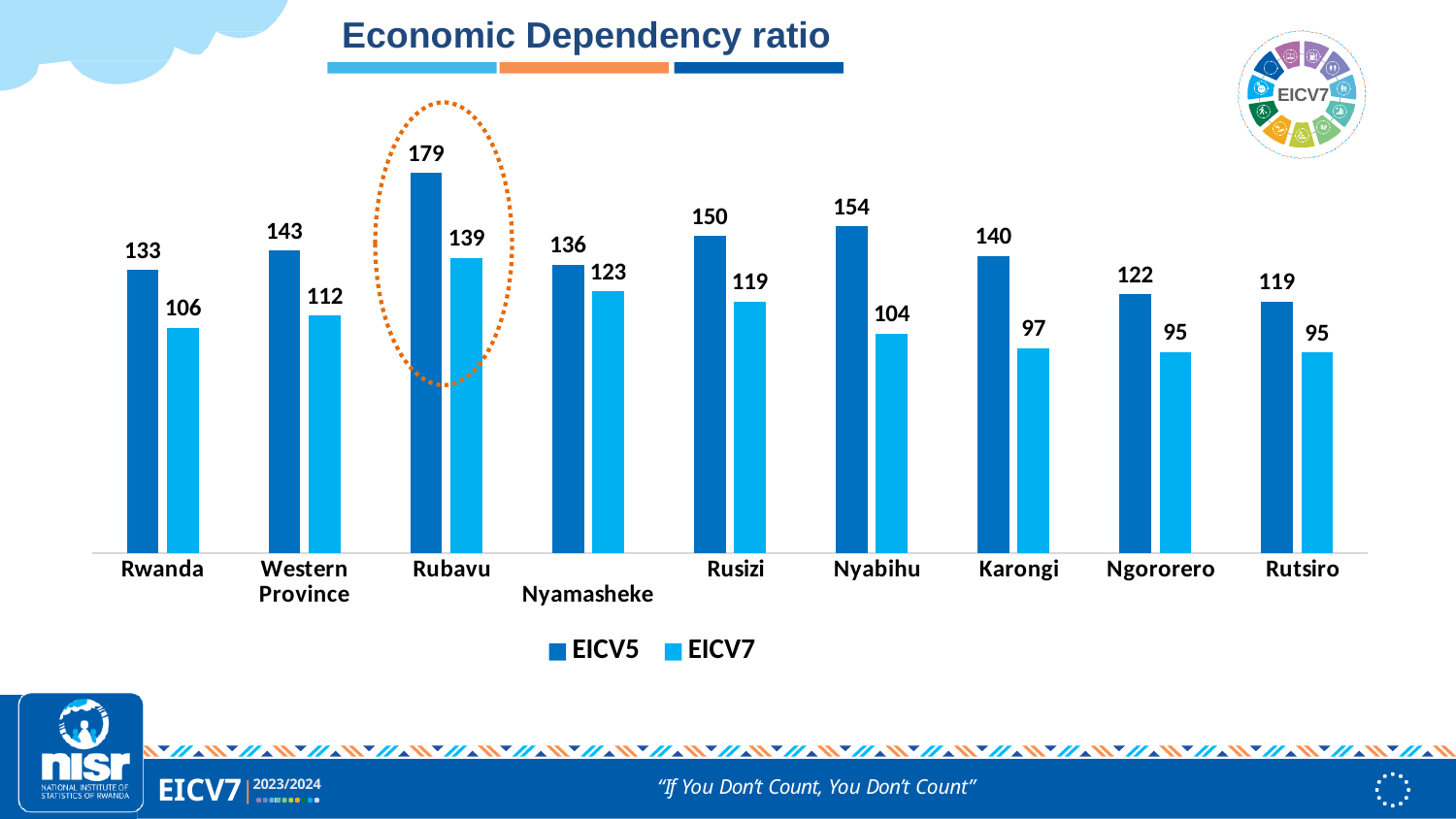
Which category has the highest EICV5 value? Rubavu How many series does the legend list? 2 What is the EICV5 economic dependency ratio for Nyabihu? 154 Which category has the lowest EICV5 value? Rutsiro How many categories are shown on the x axis? 9 What is the EICV7 economic dependency ratio for Rubavu? 139 What is the difference between the EICV5 and EICV7 values for Rubavu? 40 Which is larger, the EICV7 value for Nyamasheke or the EICV7 value for Rusizi? Nyamasheke What is the EICV7 value for Karongi? 97 What is the difference between the EICV5 values for Nyabihu and Rusizi? 4 What kind of chart is shown on the slide? Bar chart Which category is highlighted with a dotted orange circle? Rubavu